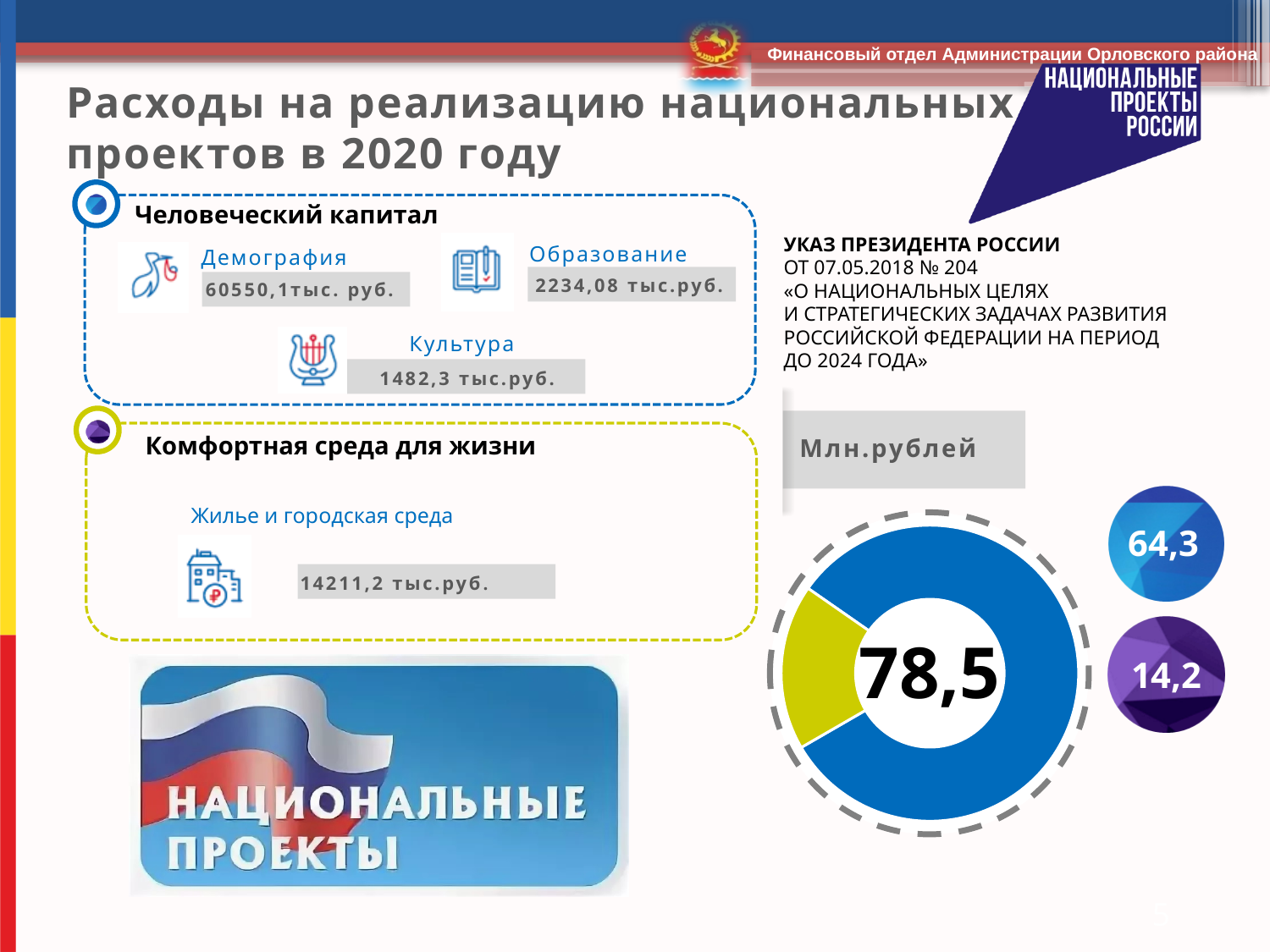
What is the difference between the two slice values of the donut chart, 64,3 and 14,2? 50,1 What value is shown for the smaller (yellow) slice of the donut chart? 14,2 What is the total value represented by the donut chart, in million rubles? 78,5 Which slice of the donut chart is the smallest, the blue one or the yellow one? the yellow one What two colours are used for the slices of the donut chart? blue and yellow How many slices does the donut chart have? 2 Which slice of the donut chart is the largest, the blue one or the yellow one? the blue one What kind of chart is shown on the right side of the slide? pie chart (donut) What value is printed in the centre of the donut chart? 78,5 What value is shown for the larger (blue) slice of the donut chart? 64,3 Which is larger in the donut chart: 64,3 or 14,2? 64,3 In what unit are the values of the donut chart expressed, according to the label above it? Млн.рублей